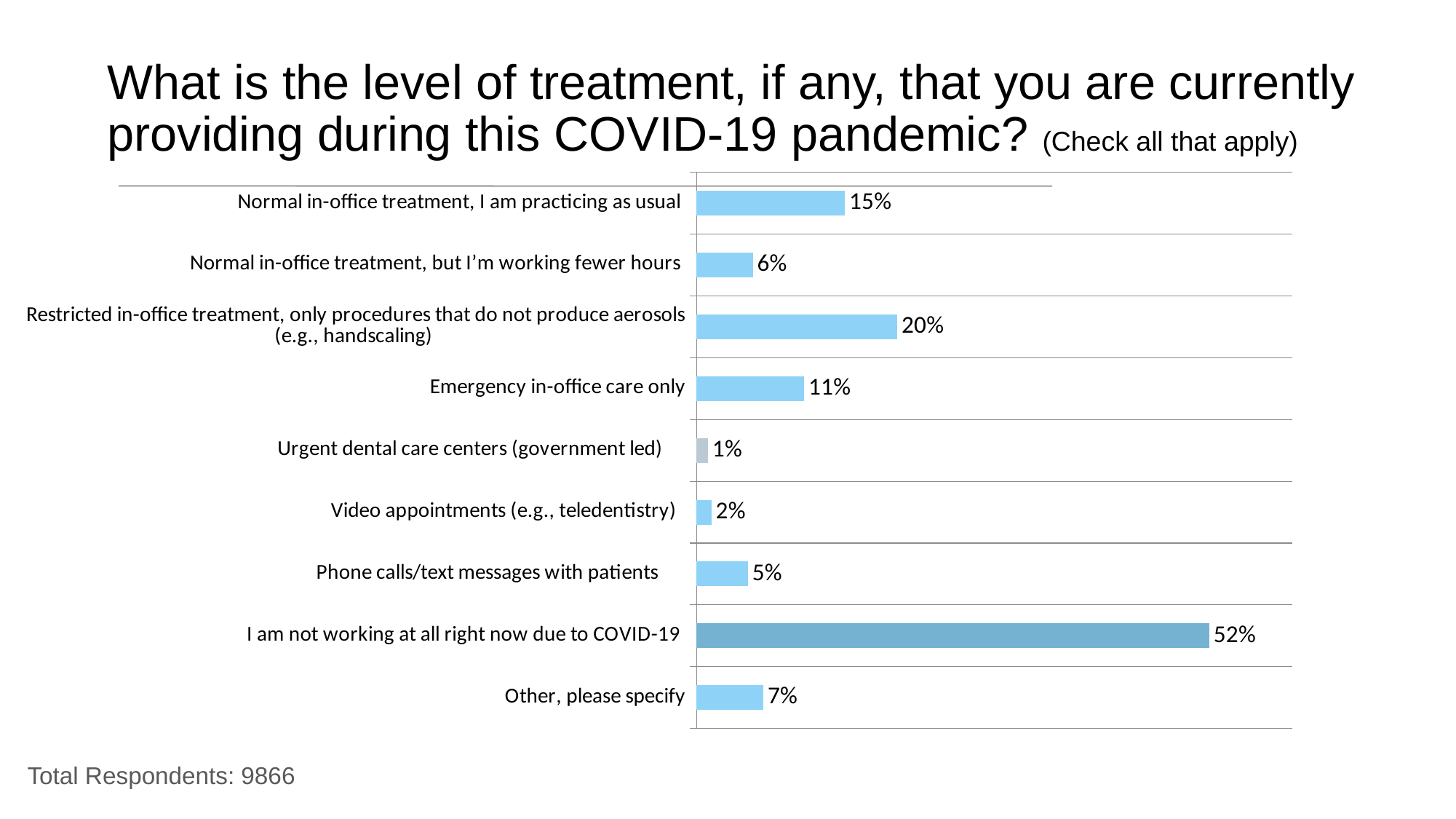
What type of chart is shown on the slide? Bar chart What percentage of respondents selected "I am not working at all right now due to COVID-19"? 52% Which bar is shown in a darker blue colour than the others? I am not working at all right now due to COVID-19 What percentage of respondents selected "Emergency in-office care only"? 11% What percentage of respondents selected "Video appointments (e.g., teledentistry)"? 2% What is the total number of respondents stated on the slide? 9866 How many response options are shown in the chart? 9 What percentage of respondents selected "Normal in-office treatment, I am practicing as usual"? 15% Which response option has the lowest percentage? Urgent dental care centers (government led) What is the difference in percentage points between "Restricted in-office treatment, only procedures that do not produce aerosols" and "Normal in-office treatment, I am practicing as usual"? 5 Which response option has the highest percentage? I am not working at all right now due to COVID-19 Which has a higher percentage: "Other, please specify" or "Normal in-office treatment, but I'm working fewer hours"? Other, please specify